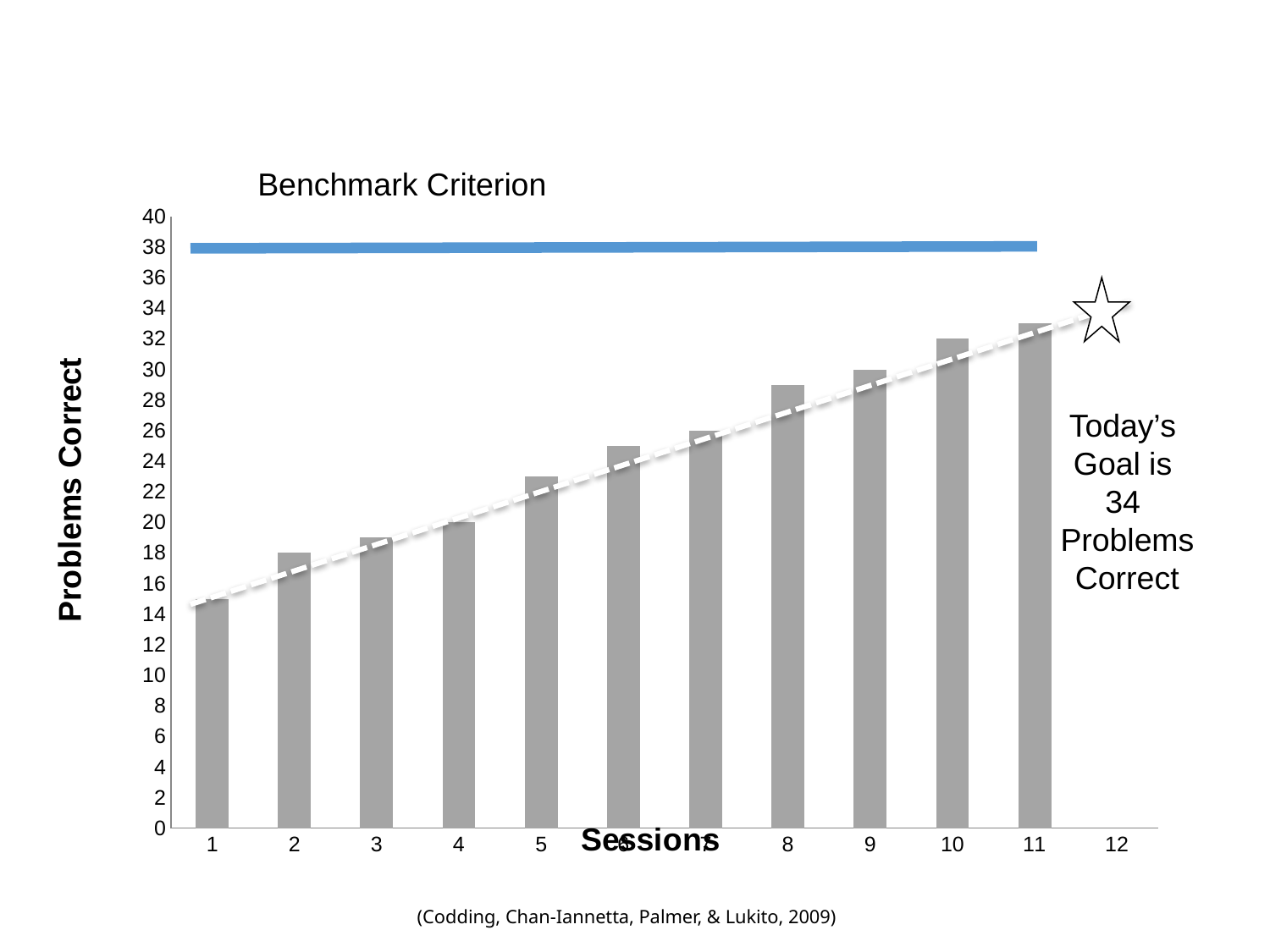
How many problems correct are shown for session 9? 30 How many problems correct are shown for session 2? 18 How many problems correct are shown for session 4? 20 Do the problems correct values rise or fall across the sessions? rise Is the value for session 1 greater or less than 16? less How many sessions have a bar plotted on the chart? 11 What kind of chart is shown on the slide? bar chart Is the value for session 11 greater or less than 30? greater How many problems correct are shown for session 10? 32 At what value on the Problems Correct axis is the Benchmark Criterion line drawn? 38 What is the difference in problems correct between session 10 and session 4? 12 Which session has the highest number of problems correct? Session 11